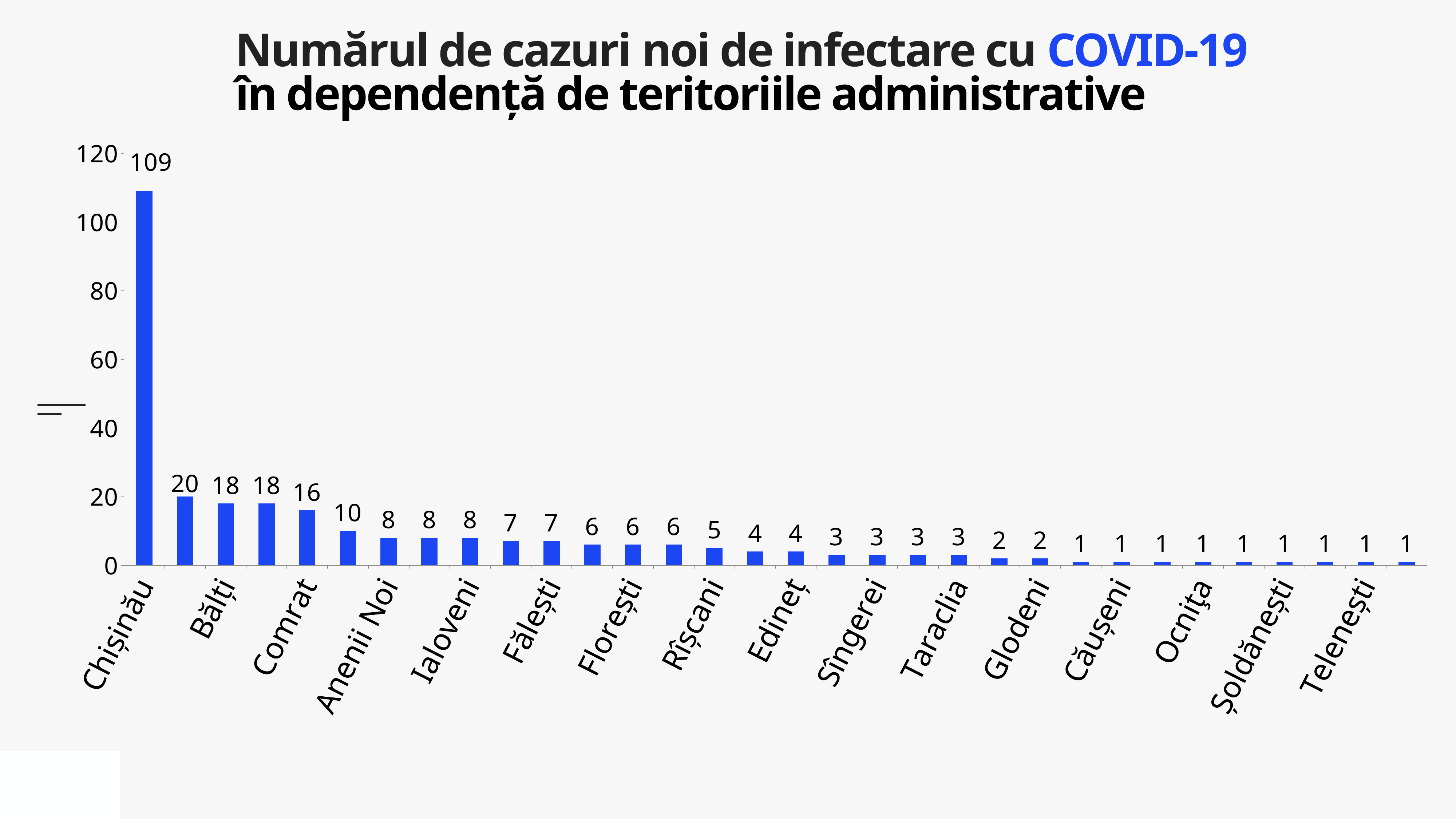
What is the lowest value shown on the chart? 1 How many bars have a value of 1? 9 What is the maximum value shown on the vertical axis? 120 What is the difference between the highest value (109) and the second-highest value (20)? 89 What colour are the bars on the chart? blue What type of chart is shown on the slide? bar chart How many bars are plotted on the chart? 32 Is the value for Chișinău greater or less than 100? greater What is the highest value shown on the chart? 109 Which category has the highest number of new COVID-19 cases? Chișinău Do the values rise or fall from left to right along the x axis? fall What is the value for Chișinău? 109